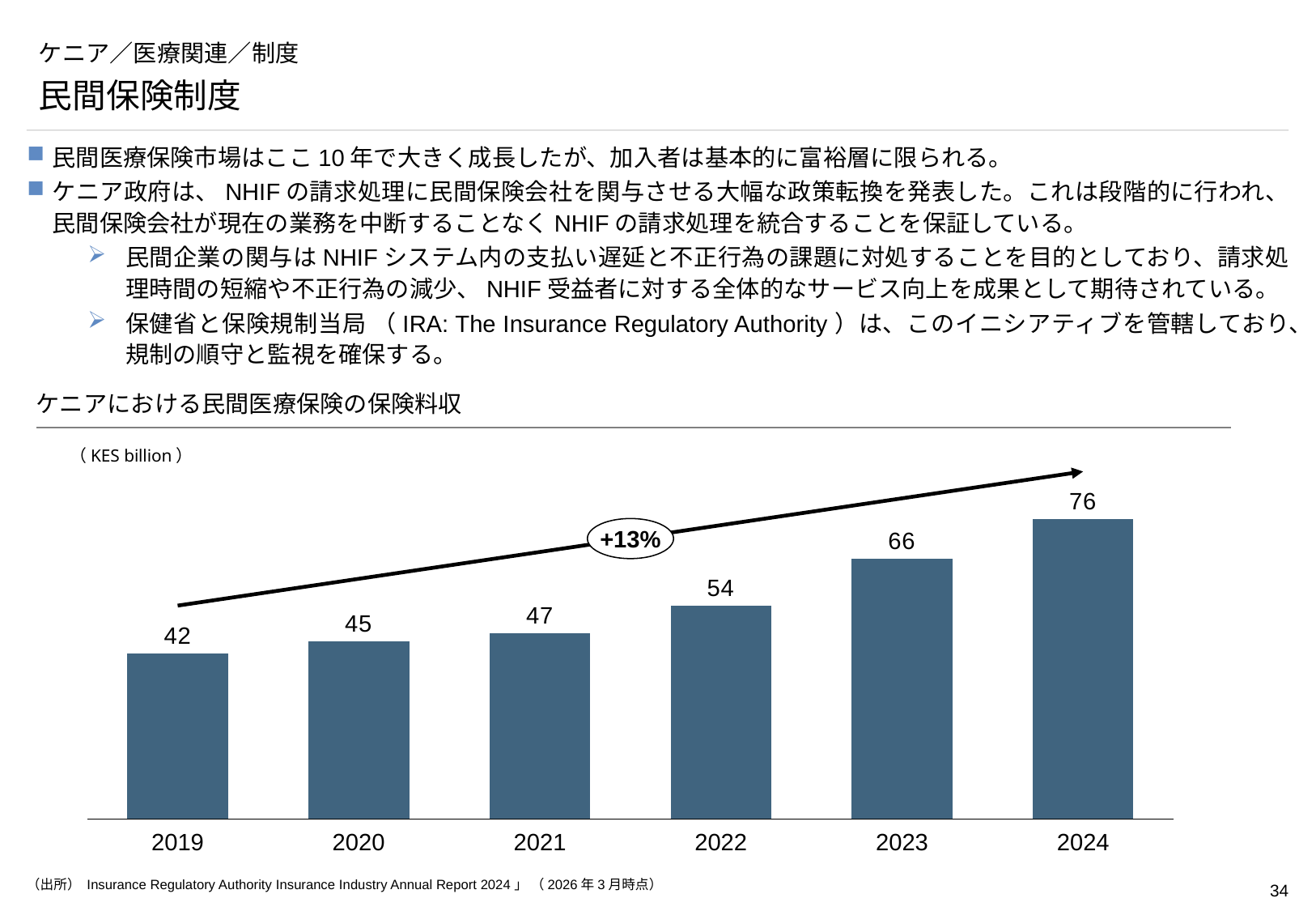
How many years are shown on the x axis? 6 Which is larger, the value for 2021 or the value for 2020? 2021 What growth rate is shown in the label on the arrow above the bars? +13% Which year has the lowest value? 2019 Do the values rise or fall from 2019 to 2024? rise What is the difference between the values for 2024 and 2019? 34 What is the value for 2024? 76 What kind of chart is this? bar chart What is the value for 2019? 42 Which year has the highest value? 2024 What is the value for 2022? 54 What is the difference between the values for 2023 and 2022? 12